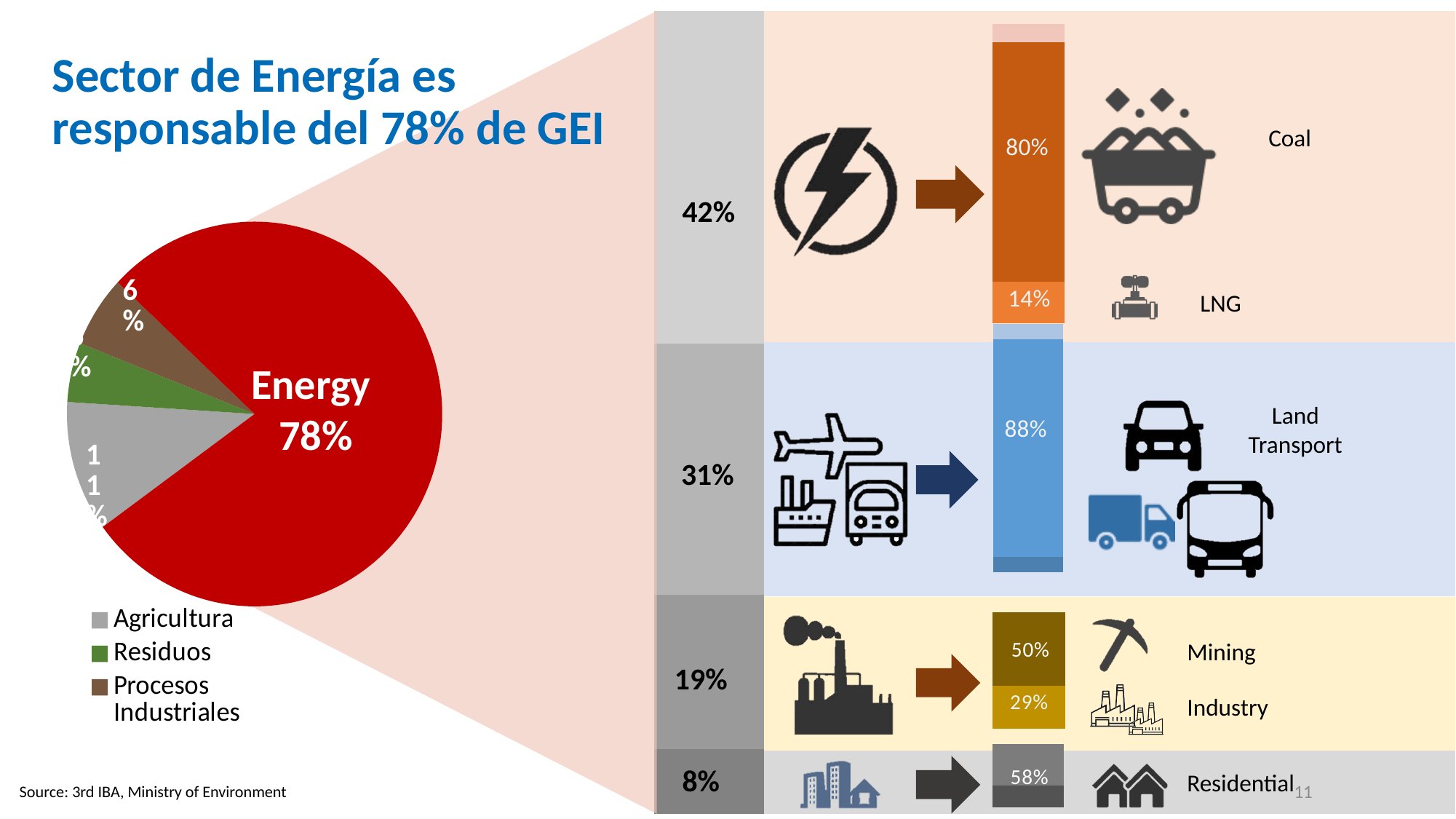
In the breakdown on the right, what percentage is shown for Coal within the electricity sector bar? 80% In the pie chart, what percentage is shown for Energy? 78% What kind of chart is shown on the left of the slide? Pie chart What colour is the Energy slice in the pie chart? Red In the pie chart, which is larger, Agricultura or Procesos Industriales? Agricultura In the breakdown on the right, what percentage is shown for the electricity sector (lightning icon)? 42% How many entries does the legend of the pie chart list? 3 In the pie chart, what is the difference between the Energy share and the Procesos Industriales share? 72% In the pie chart, which is larger, Energy or Agricultura? Energy How many slices does the pie chart have? 4 In the pie chart, what percentage is shown for Procesos Industriales? 6% In the pie chart, which category has the largest slice? Energy